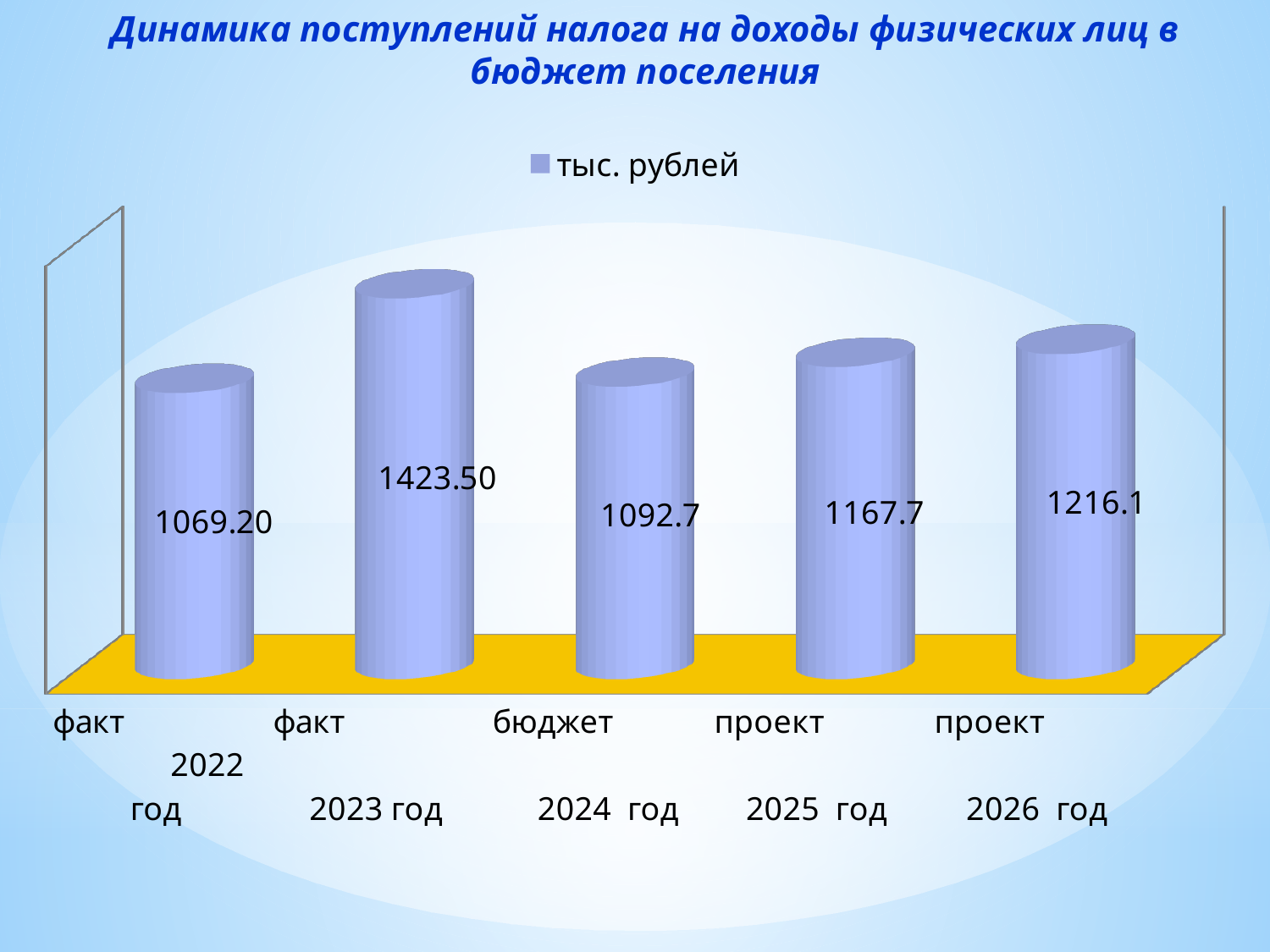
What kind of chart is shown on the slide? bar chart How many series does the legend list? 1 What is the legend entry of the chart? тыс. рублей Which category has the highest value? факт 2023 год Which is larger, the value for проект 2026 год or the value for проект 2025 год? проект 2026 год What is the difference between the values for проект 2025 год and бюджет 2024 год? 75 How many categories are shown in the chart? 5 What is the value for бюджет 2024 год? 1092.7 What is the value for факт 2023 год? 1423.50 Which category has the lowest value? факт 2022 год What is the value for проект 2026 год? 1216.1 What is the difference between the values for факт 2023 год and факт 2022 год? 354.30